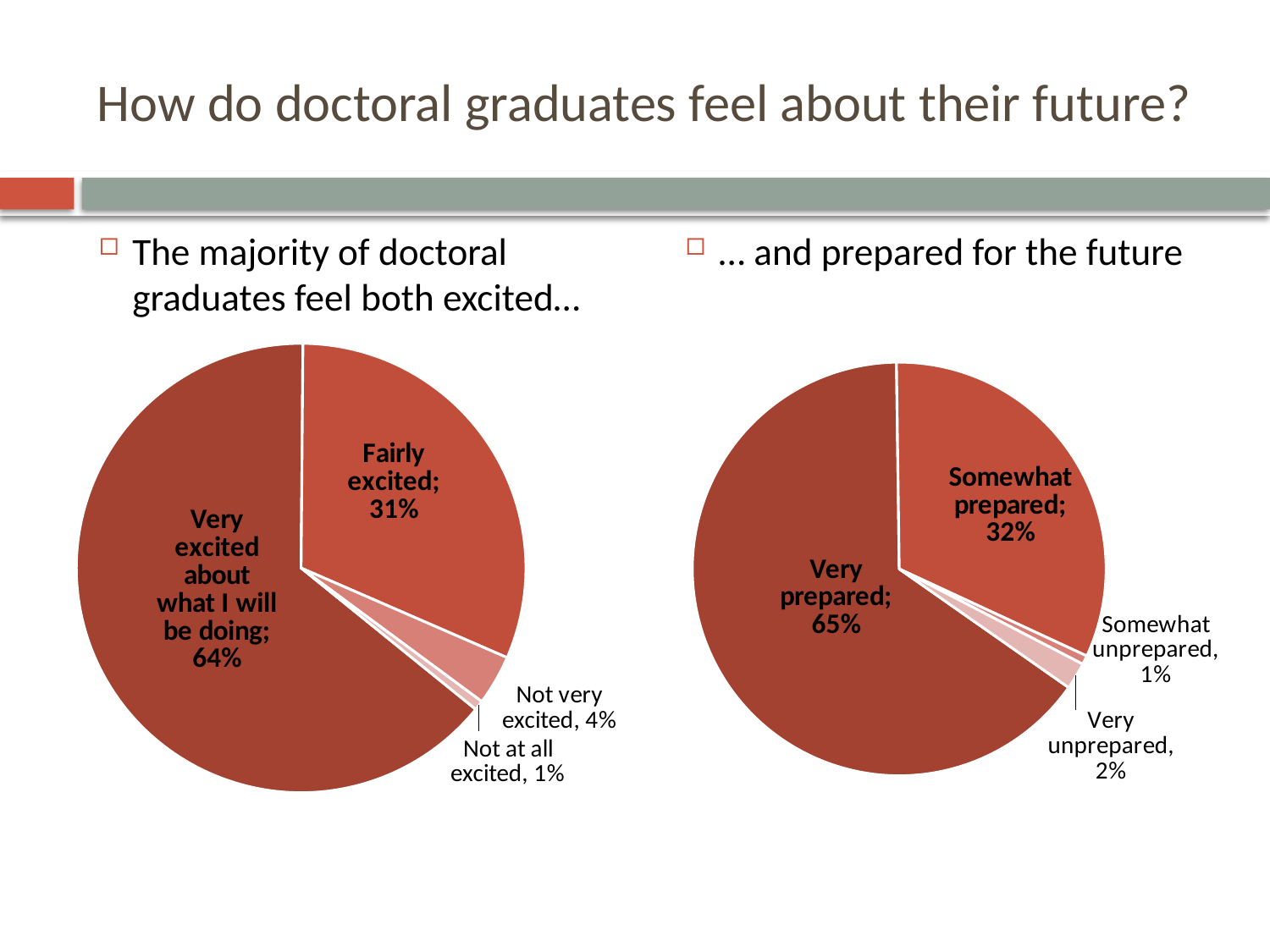
In the left pie chart (excitement), what share are not very excited? 4% How many categories does the right pie chart (preparedness) show? 4 In the right pie chart (preparedness), what share of doctoral graduates are very prepared? 65% In the right pie chart (preparedness), what is the combined share of somewhat unprepared and very unprepared? 3% In the right pie chart (preparedness), which category has the largest share? Very prepared In the left pie chart (excitement), what share of doctoral graduates are very excited about what they will be doing? 64% In the left pie chart (excitement), which category has the smallest share? Not at all excited In the left pie chart (excitement), what share are fairly excited? 31% What type of chart is used on the left side of the slide? Pie chart In the left pie chart (excitement), what is the difference between the very excited and fairly excited shares? 33% In the right pie chart (preparedness), which is larger: very unprepared or somewhat unprepared? Very unprepared In the right pie chart (preparedness), what share are somewhat unprepared? 1%